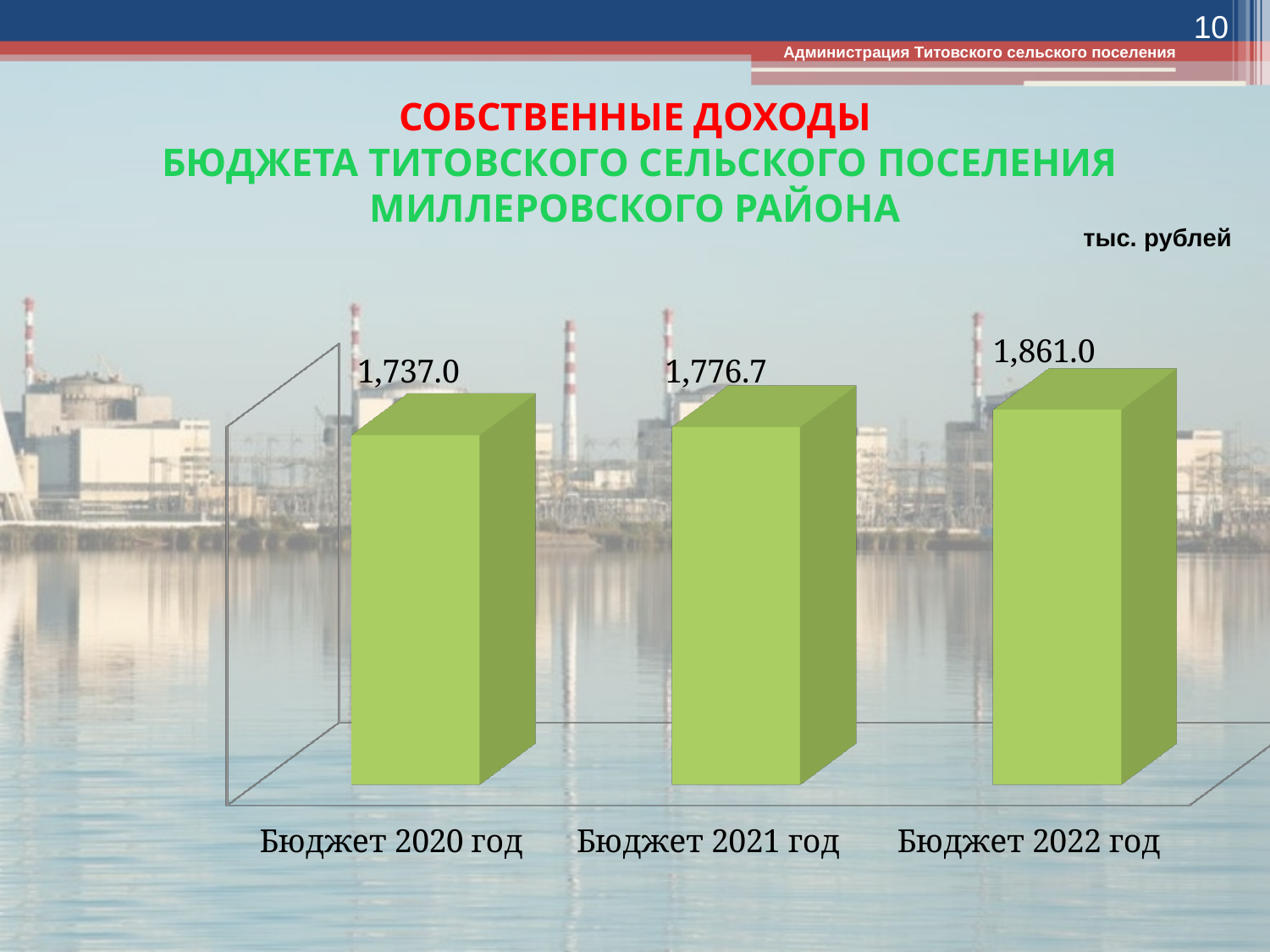
How many categories are shown in the chart? 3 Which category has the lowest value? Бюджет 2020 год Which is larger, the value for Бюджет 2021 год or Бюджет 2022 год? Бюджет 2022 год What kind of chart is shown on the slide? Bar chart What is the value for Бюджет 2021 год? 1,776.7 What is the value for Бюджет 2022 год? 1,861.0 What is the value for Бюджет 2020 год? 1,737.0 What is the difference between the values for Бюджет 2021 год and Бюджет 2020 год? 39.7 Which category has the highest value? Бюджет 2022 год What is the difference between the values for Бюджет 2022 год and Бюджет 2021 год? 84.3 Do the values rise or fall from Бюджет 2020 год to Бюджет 2022 год? Rise What is the difference between the values for Бюджет 2022 год and Бюджет 2020 год? 124.0